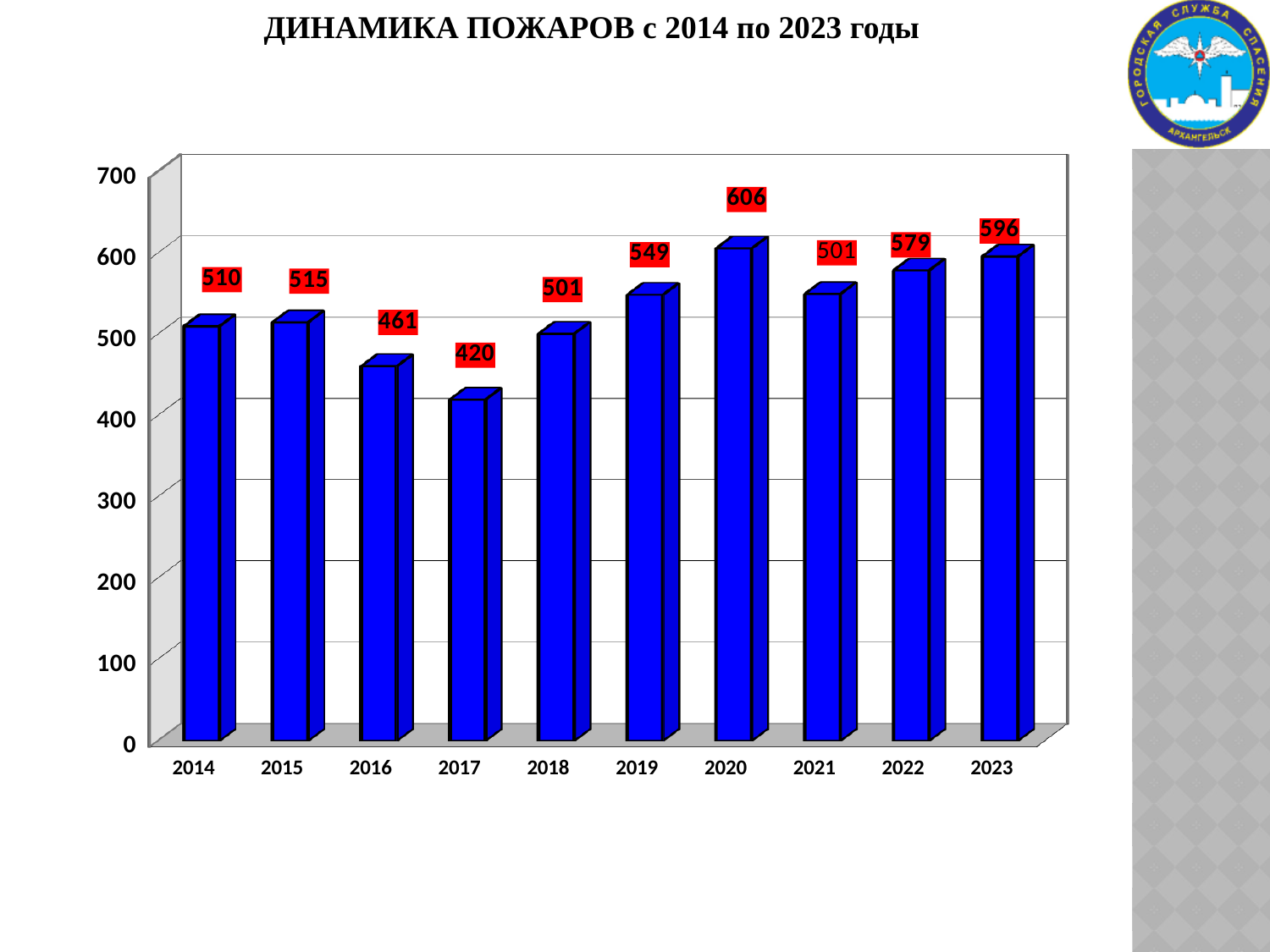
Which year has the lowest value? 2017 What is the value for 2023? 596 Which is larger, the value for 2016 or the value for 2018? 2018 What is the difference between the values for 2020 and 2017? 186 What is the difference between the values for 2023 and 2022? 17 What is the value for 2017? 420 What kind of chart is shown on the slide? bar chart How many years are shown on the x axis? 10 What is the value for 2020? 606 Is the value for 2019 greater or less than 500? greater What is the title of the chart? ДИНАМИКА ПОЖАРОВ с 2014 по 2023 годы Which year has the highest value? 2020